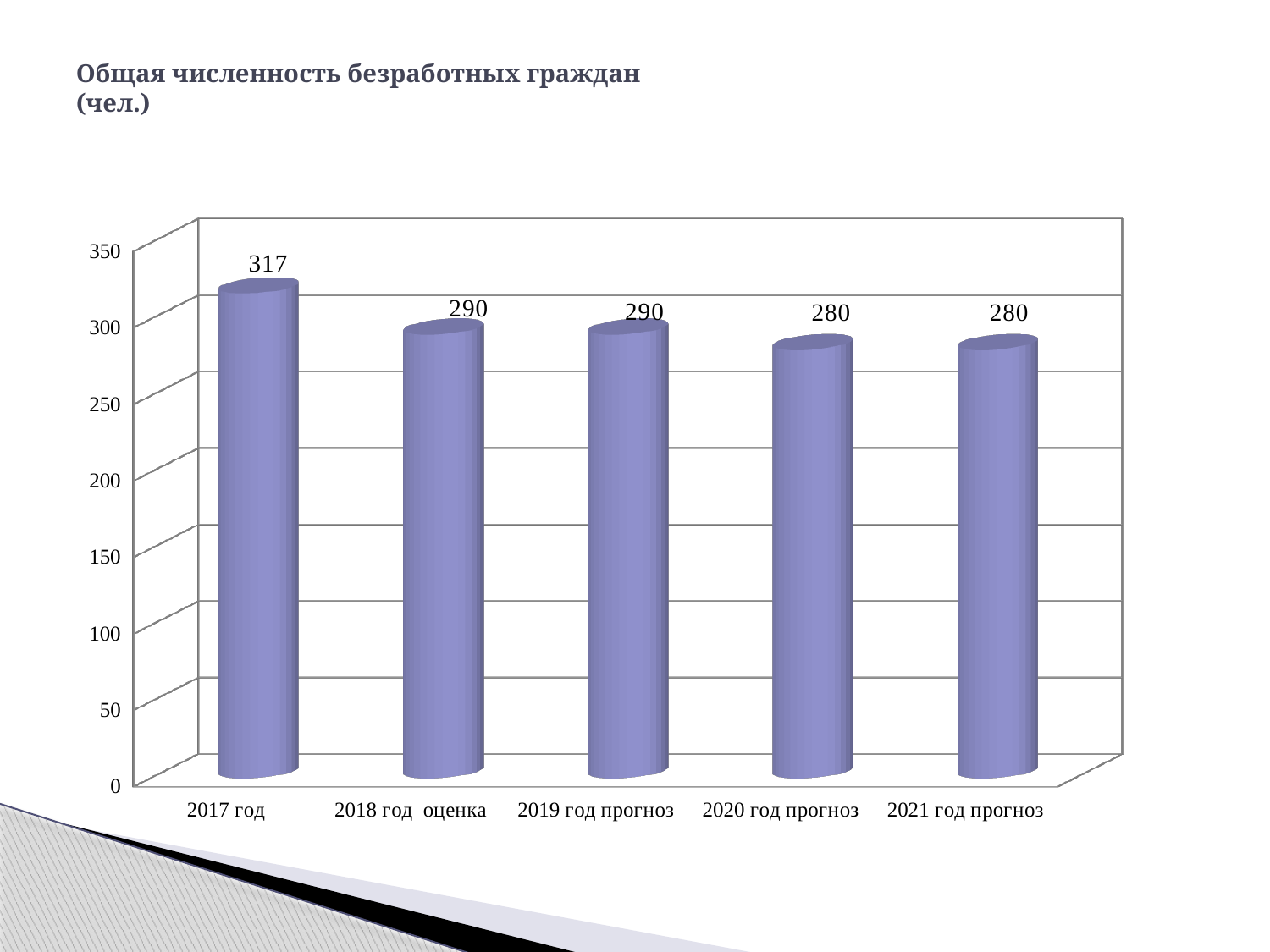
Is the value for 2021 год прогноз greater or less than 300? less How many categories are shown on the x axis? 5 What is the value for 2017 год? 317 What kind of chart is shown on the slide? bar chart What is the value for 2020 год прогноз? 280 What is the value for 2018 год оценка? 290 Which category has the highest value? 2017 год What is the title of the slide? Общая численность безработных граждан (чел.) What is the difference between the values for 2019 год прогноз and 2021 год прогноз? 10 What is the difference between the values for 2017 год and 2018 год оценка? 27 Which is larger, the value for 2017 год or the value for 2020 год прогноз? 2017 год Do the values rise or fall from 2017 год to 2021 год прогноз? fall